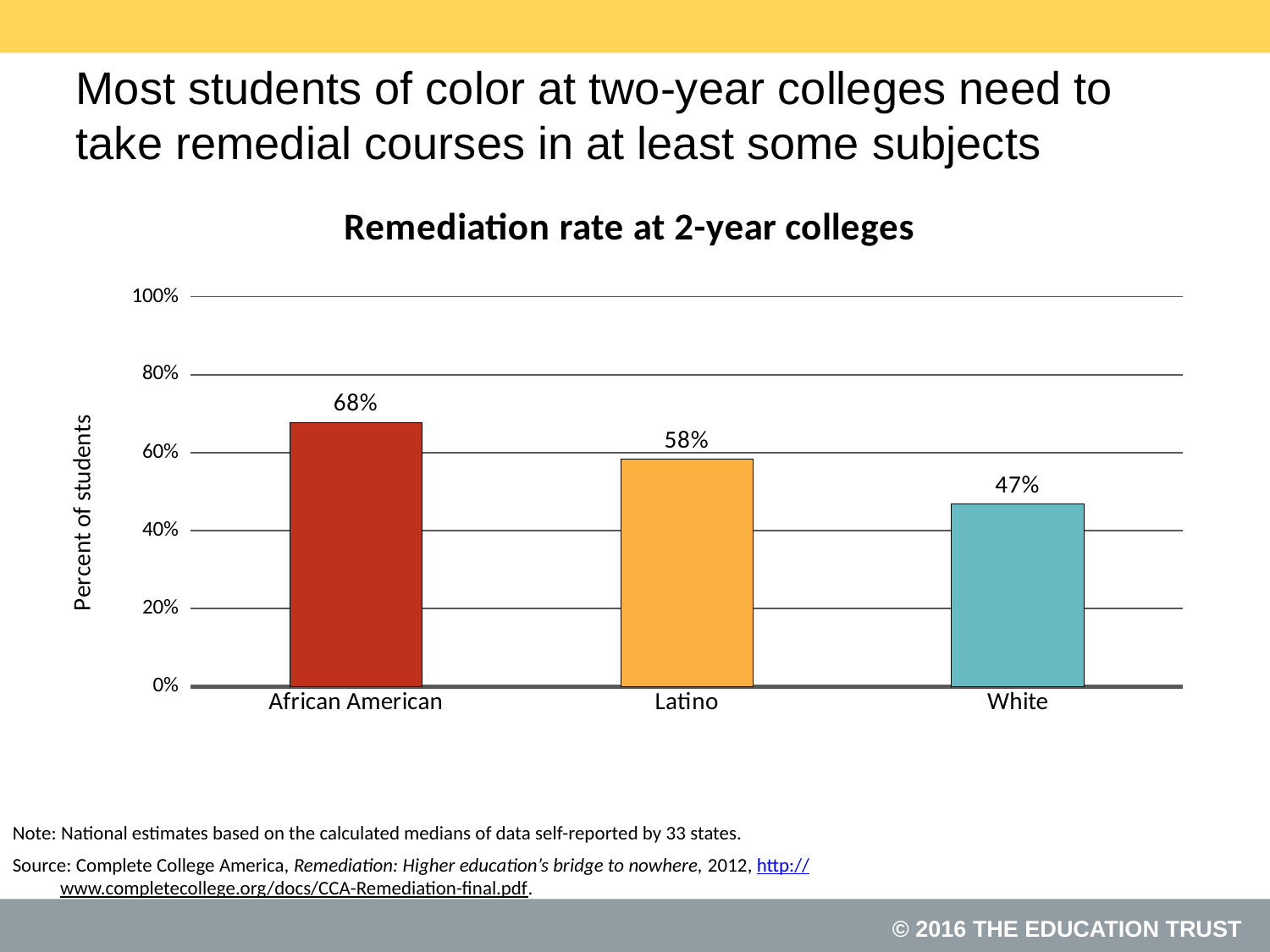
What is the remediation rate for White students? 47% Which group has the highest remediation rate? African American What is the difference between the remediation rates for Latino and White students? 11% What is the remediation rate for Latino students? 58% What is the title of the chart? Remediation rate at 2-year colleges Is the value for White students greater or less than 60%? less What is the difference between the remediation rates for African American and White students? 21% What is the remediation rate for African American students? 68% Which group has the lowest remediation rate? White What kind of chart is shown on the slide? bar chart How many groups are shown in the chart? 3 Which is larger, the remediation rate for Latino students or for White students? Latino